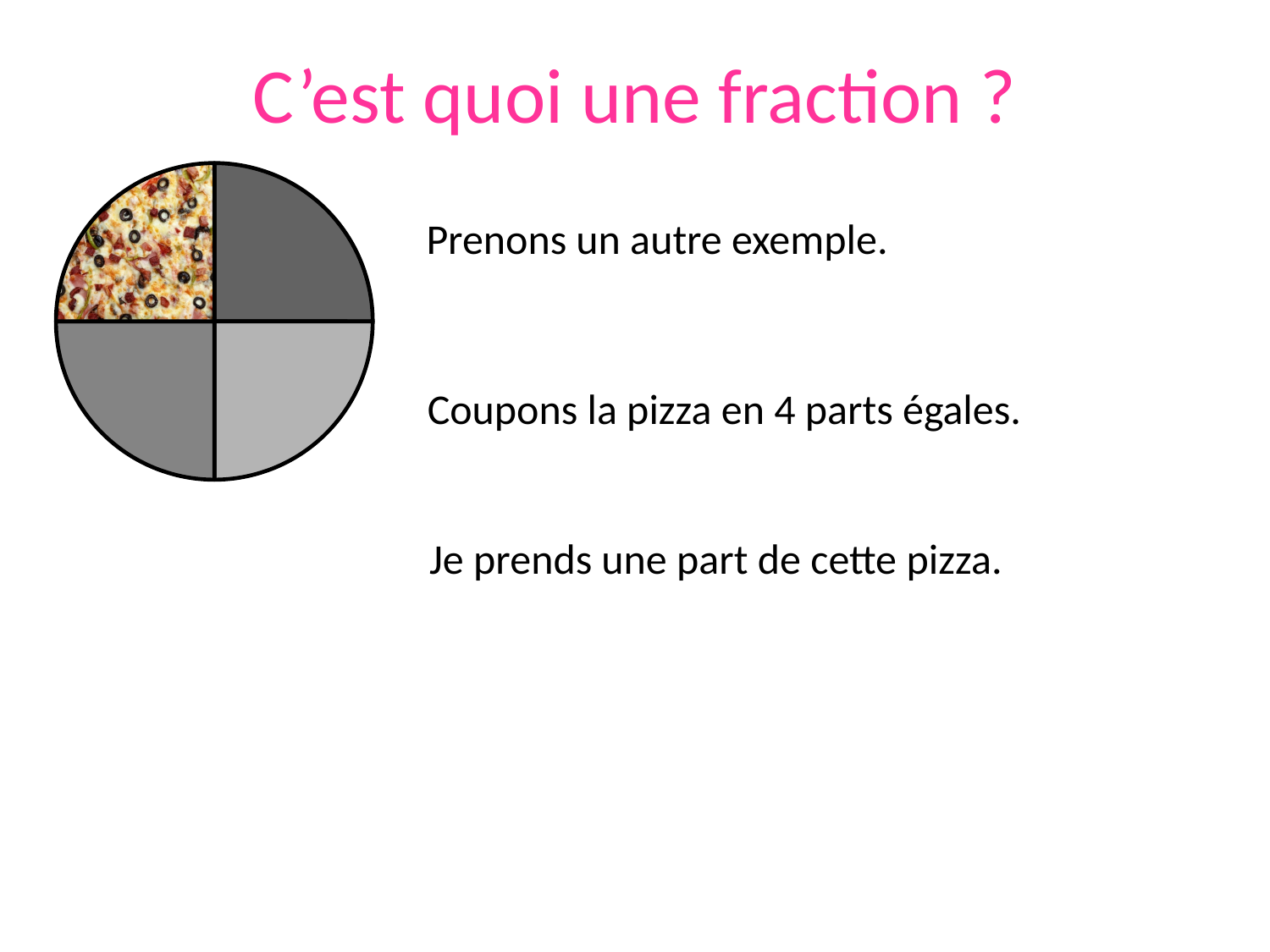
What is the title of the slide containing the pie chart? C’est quoi une fraction ? What share of the whole pizza does one slice of the pie chart represent? 1/4 What kind of chart is shown on the slide? pie chart According to the slide, into how many equal parts is the pizza cut? 4 How many slices of the pie chart are filled with a pizza image rather than a grey colour? 1 How many slices does the pie chart have? 4